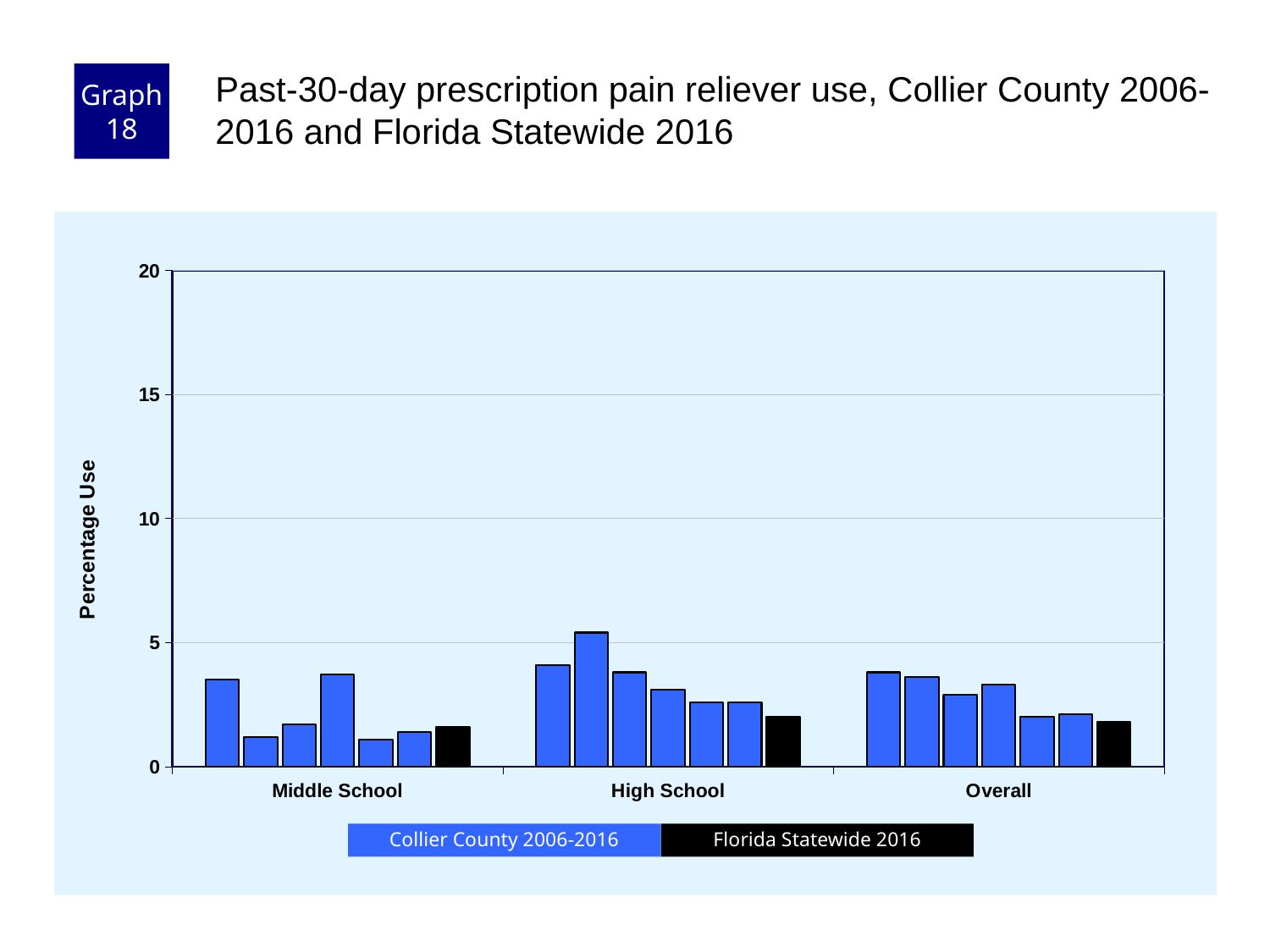
Is the Florida Statewide 2016 value for High School greater or less than 5? less Is the Florida Statewide 2016 bar larger for Middle School or for High School? High School Is the tallest Collier County 2006-2016 bar for High School greater or less than 10? less What kind of chart is shown on the slide? bar chart How many series does the legend list? 2 How many categories are shown on the x axis? 3 What is the highest value shown on the y axis? 20 Which series is shown in black in the legend? Florida Statewide 2016 Is the Florida Statewide 2016 value for Middle School greater or less than 5? less What is the label of the y axis? Percentage Use Which category contains the tallest bar in the chart? High School